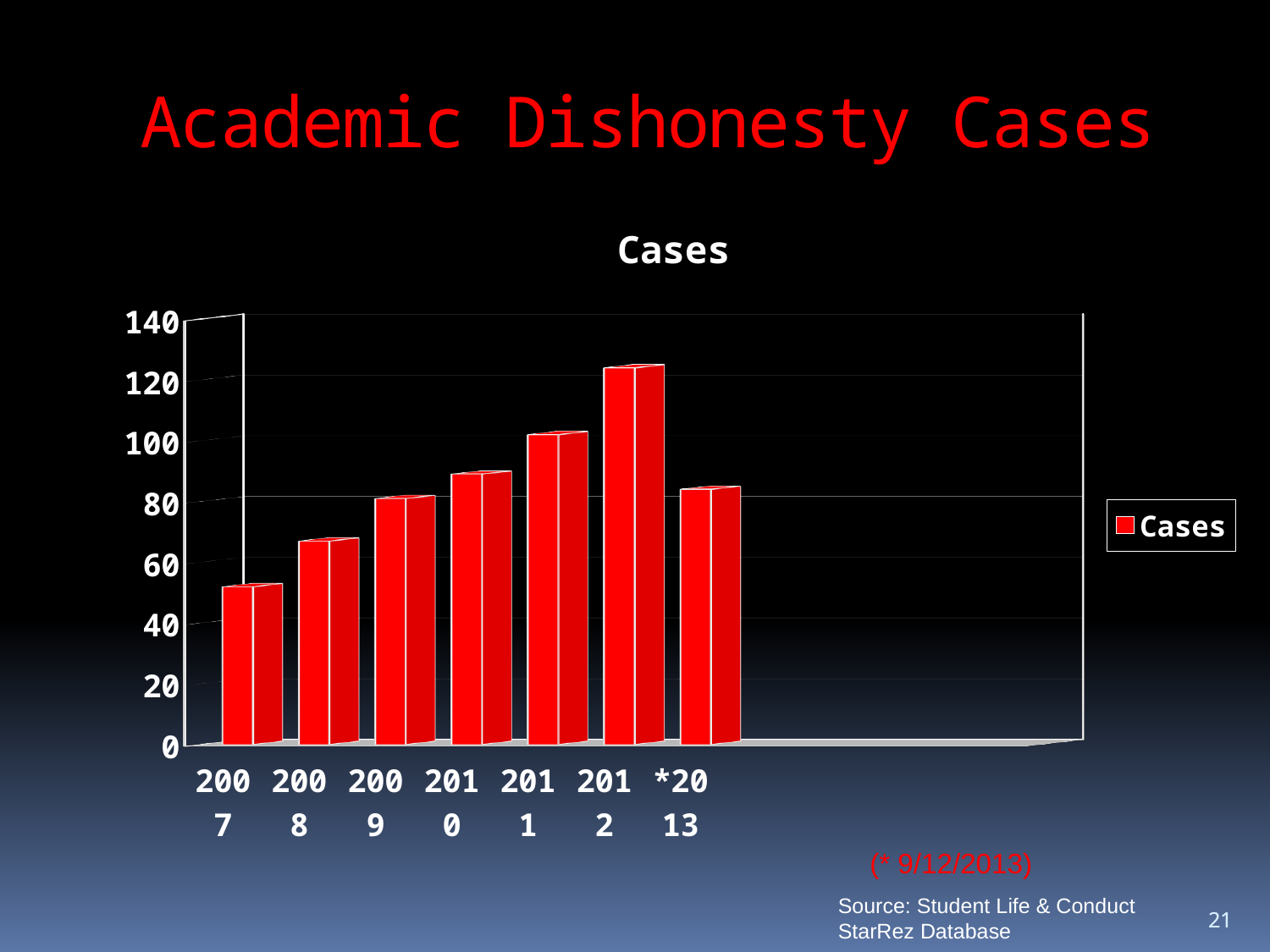
Is the value for 2010 greater or less than 80? greater Which has more cases, 2012 or *2013? 2012 Is the value for 2007 greater or less than 60? less Is the value for *2013 greater or less than 100? less How many categories (years) are plotted on the chart? 7 What kind of chart is shown on the slide? bar chart Which year has the lowest number of cases? 2007 Do the values rise or fall from 2007 to 2012? rise How many series does the legend list? 1 Which year has the highest number of cases? 2012 What is the title of the chart? Cases